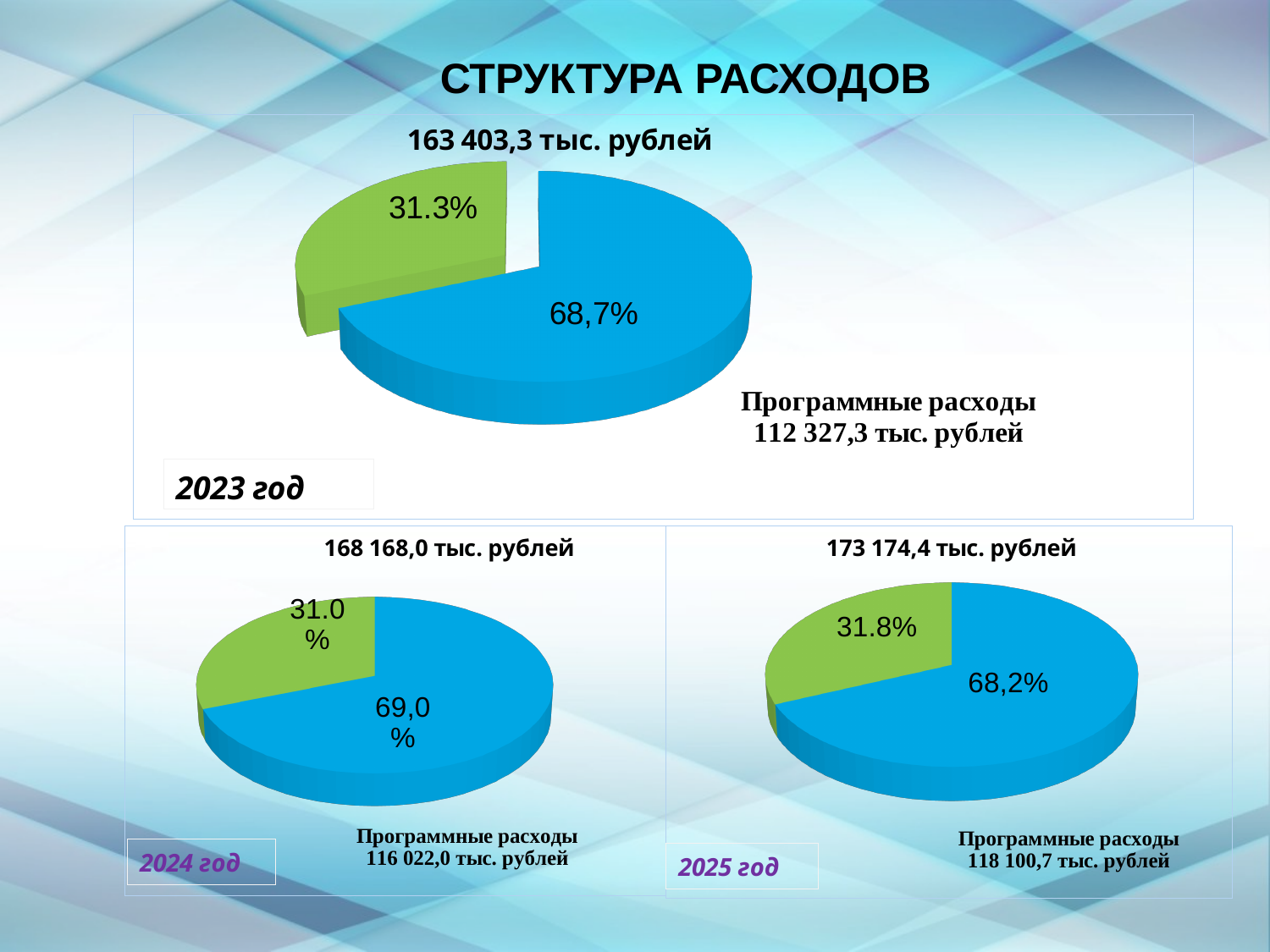
In the 2025 год pie chart, what percentage is shown on the green slice? 31.8% What total amount is shown above the 2023 год pie chart? 163 403,3 тыс. рублей What is the amount of Программные расходы shown for the 2024 год chart? 116 022,0 тыс. рублей In the 2023 год pie chart, what percentage is shown on the green slice? 31.3% In the 2025 год pie chart, which slice is larger, the blue one or the green one? the blue one How many pie charts are shown on the slide? 3 How many slices does the 2024 год pie chart have? 2 In the 2023 год pie chart, what percentage is shown on the blue slice? 68,7% In the 2025 год pie chart, what is the difference in percentage points between the blue slice and the green slice? 36.4 What is the amount of Программные расходы shown for the 2025 год chart? 118 100,7 тыс. рублей What kind of chart is used for the 2023 год data? pie chart In the 2024 год pie chart, what percentage is shown on the blue slice? 69,0%